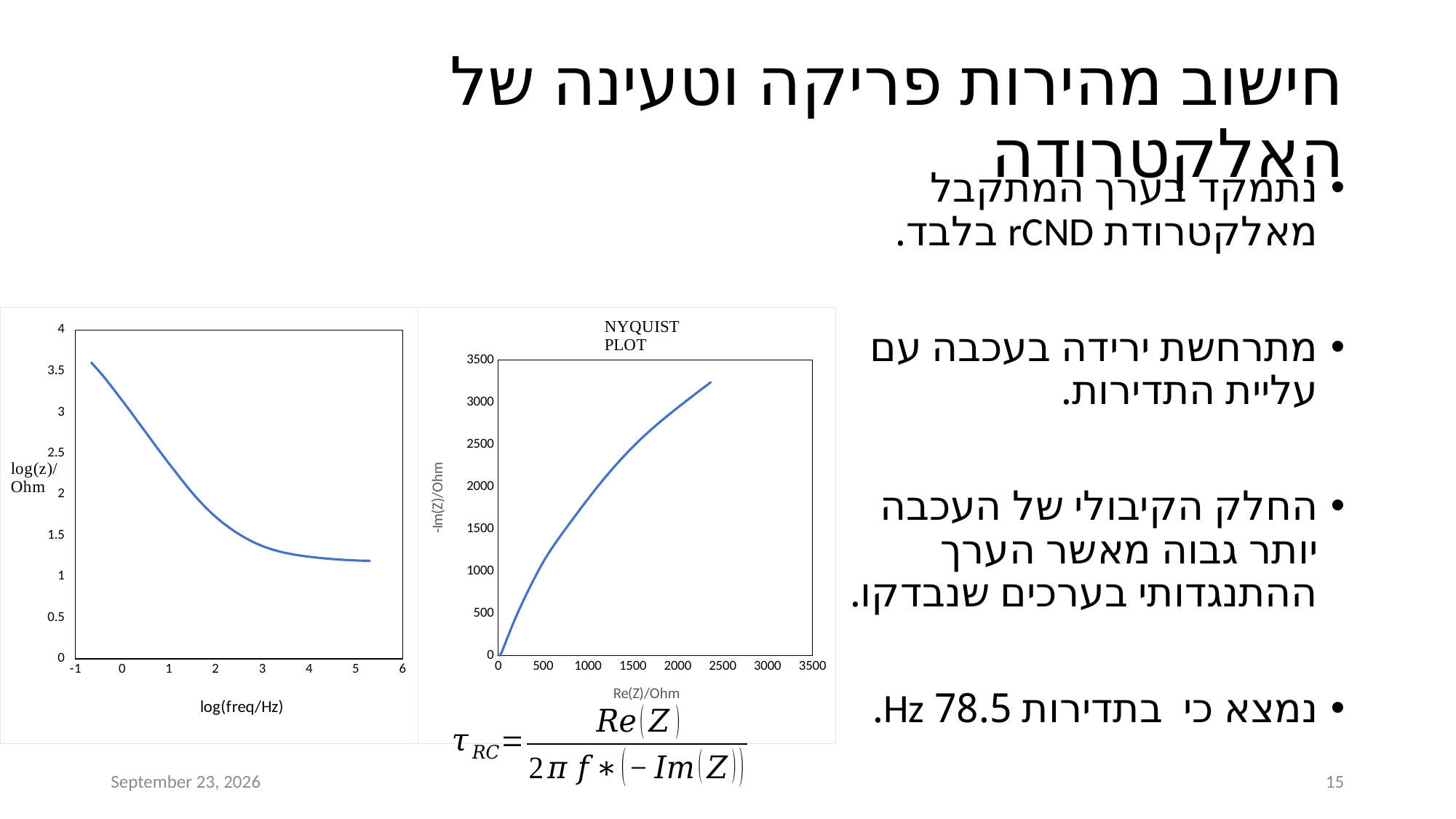
In the NYQUIST PLOT, is the highest plotted value of -Im(Z)/Ohm greater or less than 3500? less In the left chart, is the value of log(z)/Ohm at log(freq/Hz) = 5 greater or less than 1.5? less What is the x-axis label of the left chart? log(freq/Hz) In the left chart, does log(z)/Ohm rise or fall as log(freq/Hz) increases? fall In the NYQUIST PLOT, is the value of -Im(Z)/Ohm at Re(Z)/Ohm = 1000 greater or less than 1500? greater What kind of chart is the NYQUIST PLOT on the right? line chart In the NYQUIST PLOT, does -Im(Z)/Ohm rise or fall as Re(Z)/Ohm increases? rise What kind of chart is the left chart with log(freq/Hz) on the x axis? line chart How many lines are plotted in the NYQUIST PLOT? 1 What is the title of the right chart? NYQUIST PLOT